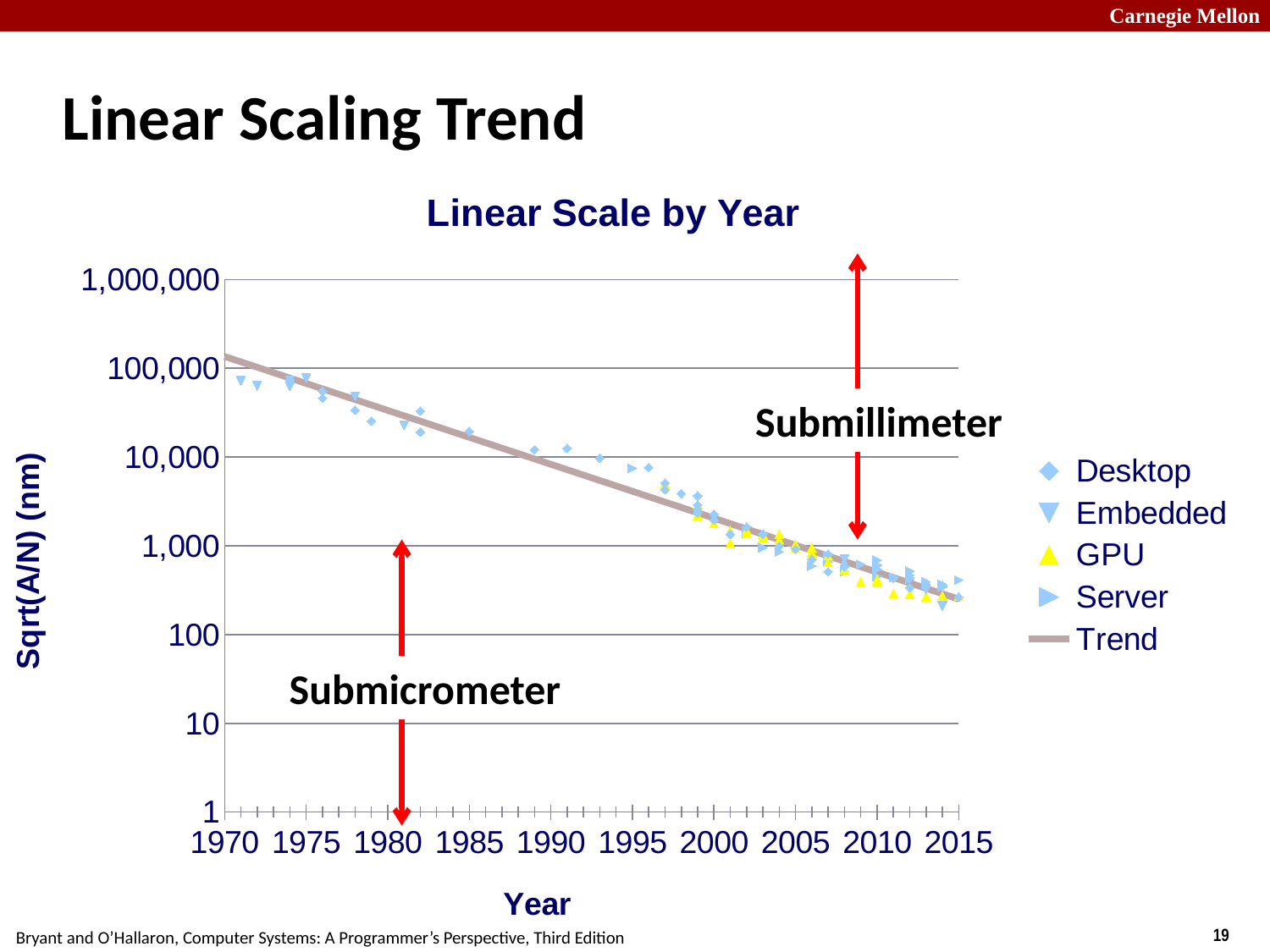
Are the GPU values plotted around 2012 greater or less than 1,000? less Are the Embedded values plotted in the early 1970s greater or less than 10,000? greater Are the Embedded values plotted in the early 1970s greater or less than 100,000? less What kind of chart is shown on the slide? scatter chart Which series is plotted with yellow triangle markers? GPU What is the title of the chart? Linear Scale by Year How many labeled tick marks are there on the Year axis? 10 How many series does the legend list? 5 Do the plotted values rise or fall as the year increases along the x axis? fall What is the label of the vertical axis? Sqrt(A/N) (nm)